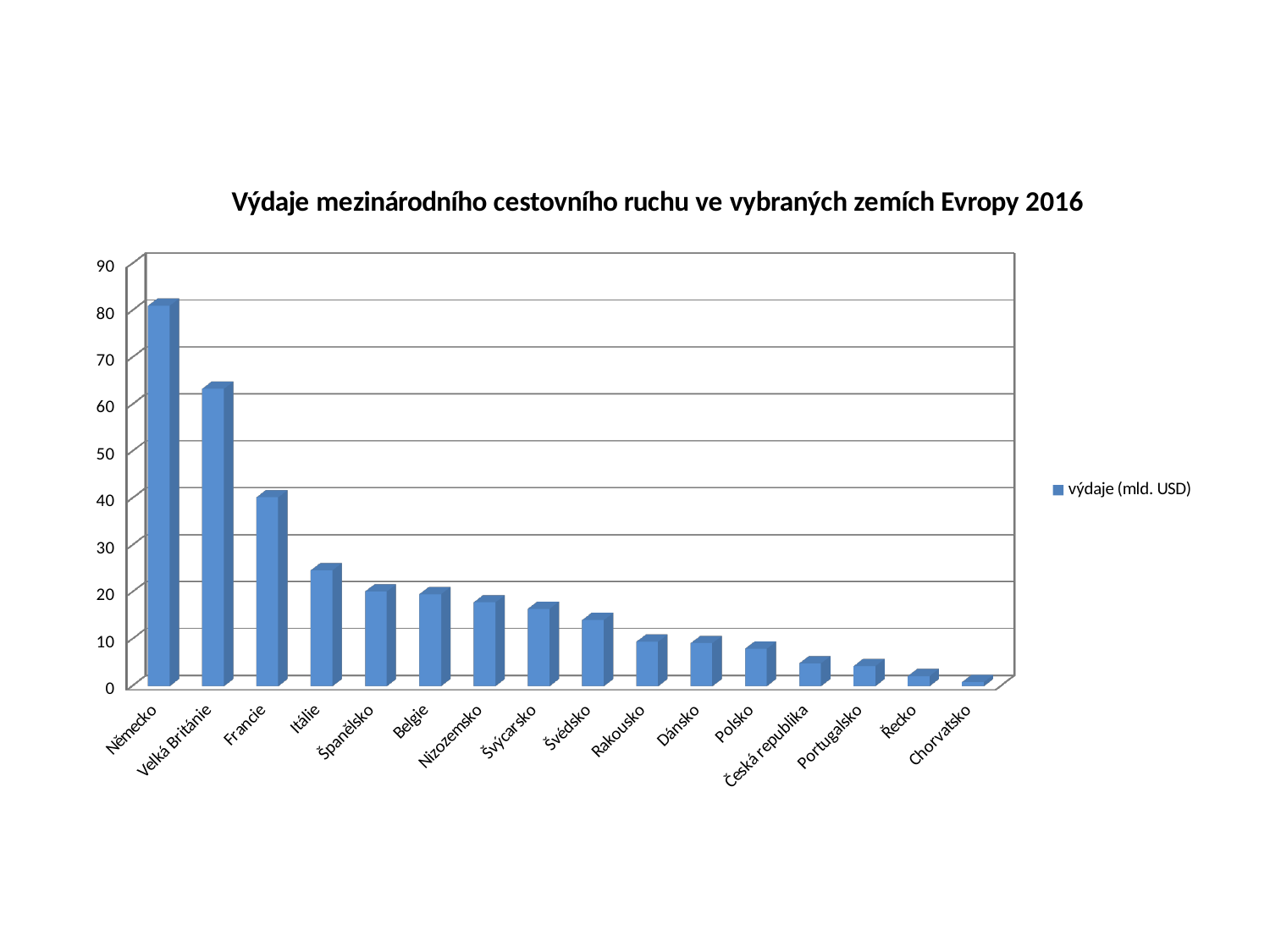
Is the value for Polsko greater or less than 10? less Which country has the lowest value in the chart? Chorvatsko How many series does the legend list? 1 Is the value for Itálie greater or less than 30? less Which country has the highest value in the chart? Německo Is the value for Velká Británie greater or less than 50? greater Do the values rise or fall moving from left to right along the x axis? fall Which is larger, the value for Francie or the value for Španělsko? Francie How many countries are shown on the x axis of the chart? 16 What kind of chart is shown on the slide? bar chart